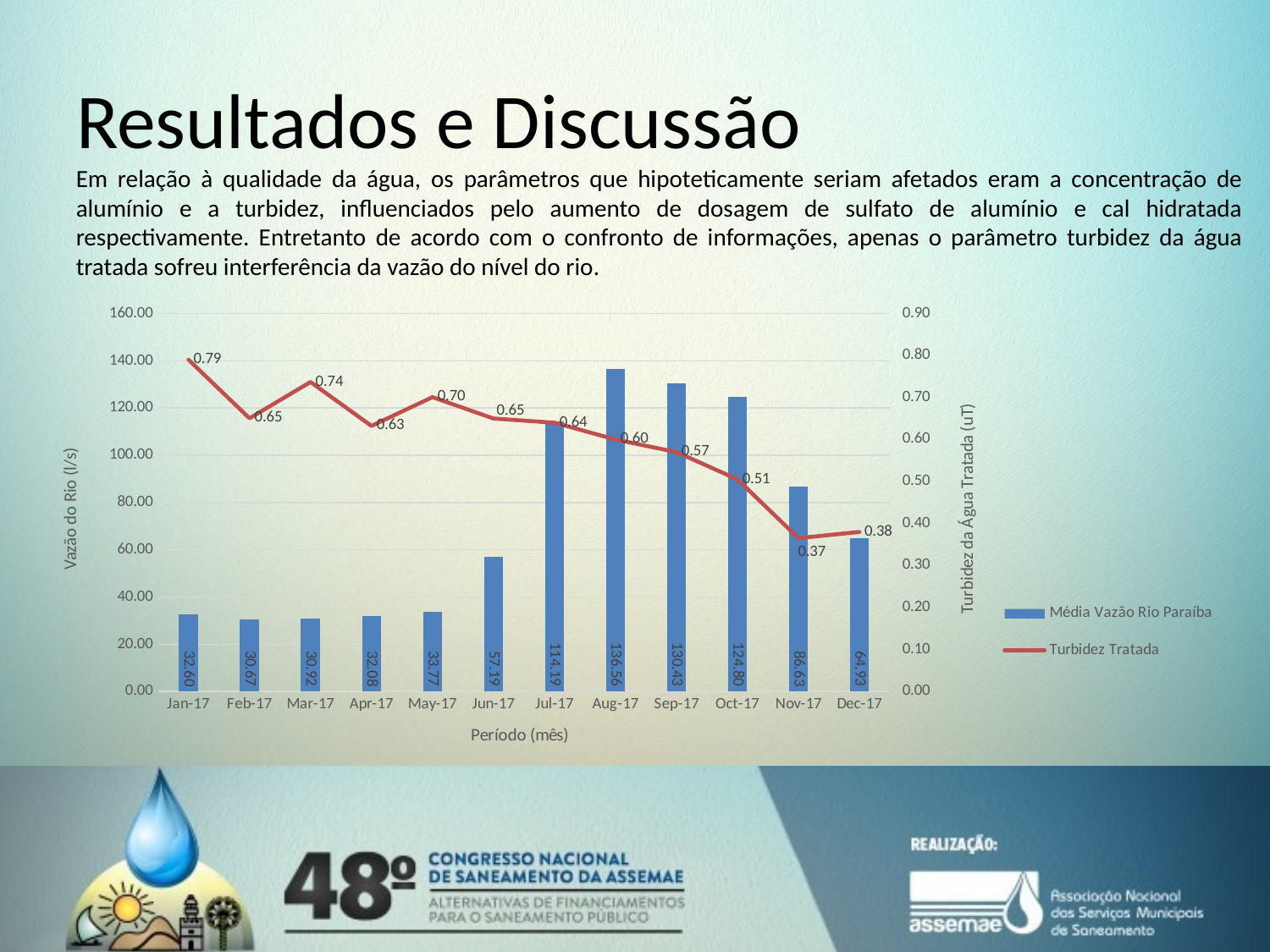
What is the difference between the Média Vazão Rio Paraíba values for Aug-17 and Sep-17? 6.13 What kinds of chart are combined in this chart? Bar chart and line chart What is the Média Vazão Rio Paraíba value for Aug-17? 136.56 Which is larger, the Turbidez Tratada value for Mar-17 or for May-17? Mar-17 Which month has the lowest Turbidez Tratada value? Nov-17 How many months are shown on the x axis? 12 How many series does the legend list? 2 What is the Média Vazão Rio Paraíba value for Jun-17? 57.19 What is the label of the right-hand vertical axis? Turbidez da Água Tratada (uT) What is the Turbidez Tratada value for Jan-17? 0.79 Does the Turbidez Tratada line generally rise or fall from Jan-17 to Dec-17? Fall Which month has the highest Média Vazão Rio Paraíba? Aug-17